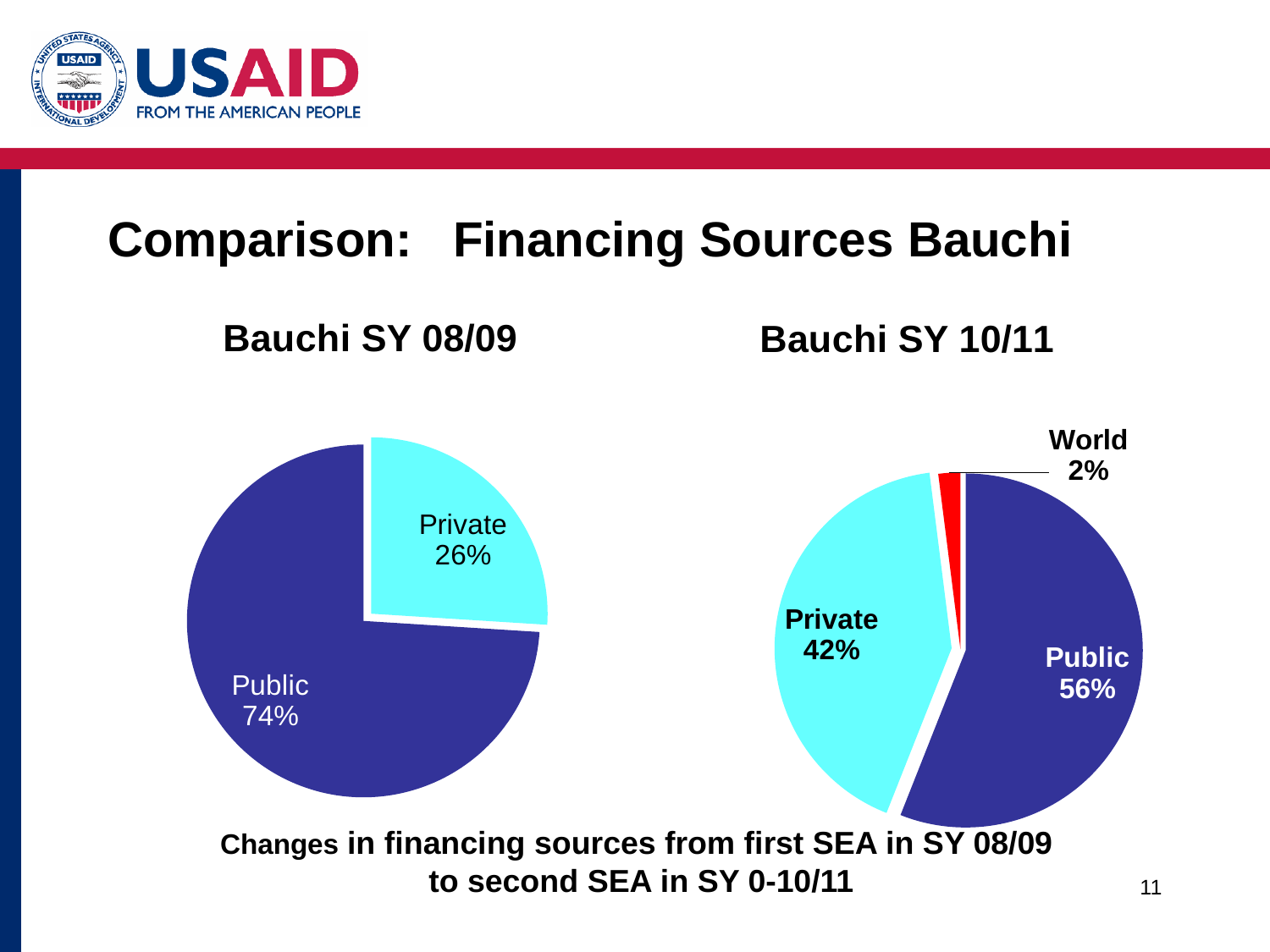
In the Bauchi SY 10/11 chart, which slice is the smallest? World In the Bauchi SY 10/11 chart, what share does Public have? 56% What kind of chart is the Bauchi SY 08/09 chart? Pie chart In the Bauchi SY 10/11 chart, what is the difference between the Public and Private shares? 14% In the Bauchi SY 10/11 chart, which slice is the largest? Public How many slices does the Bauchi SY 10/11 chart have? 3 In the Bauchi SY 08/09 chart, what is the difference between the Public and Private shares? 48% In the Bauchi SY 08/09 chart, what share does Public have? 74% In the Bauchi SY 08/09 chart, what share does Private have? 26% Which is larger: the Private share in Bauchi SY 08/09 or the Private share in Bauchi SY 10/11? Bauchi SY 10/11 In the Bauchi SY 10/11 chart, what colour is the World slice? Red In the Bauchi SY 10/11 chart, what share does World have? 2%